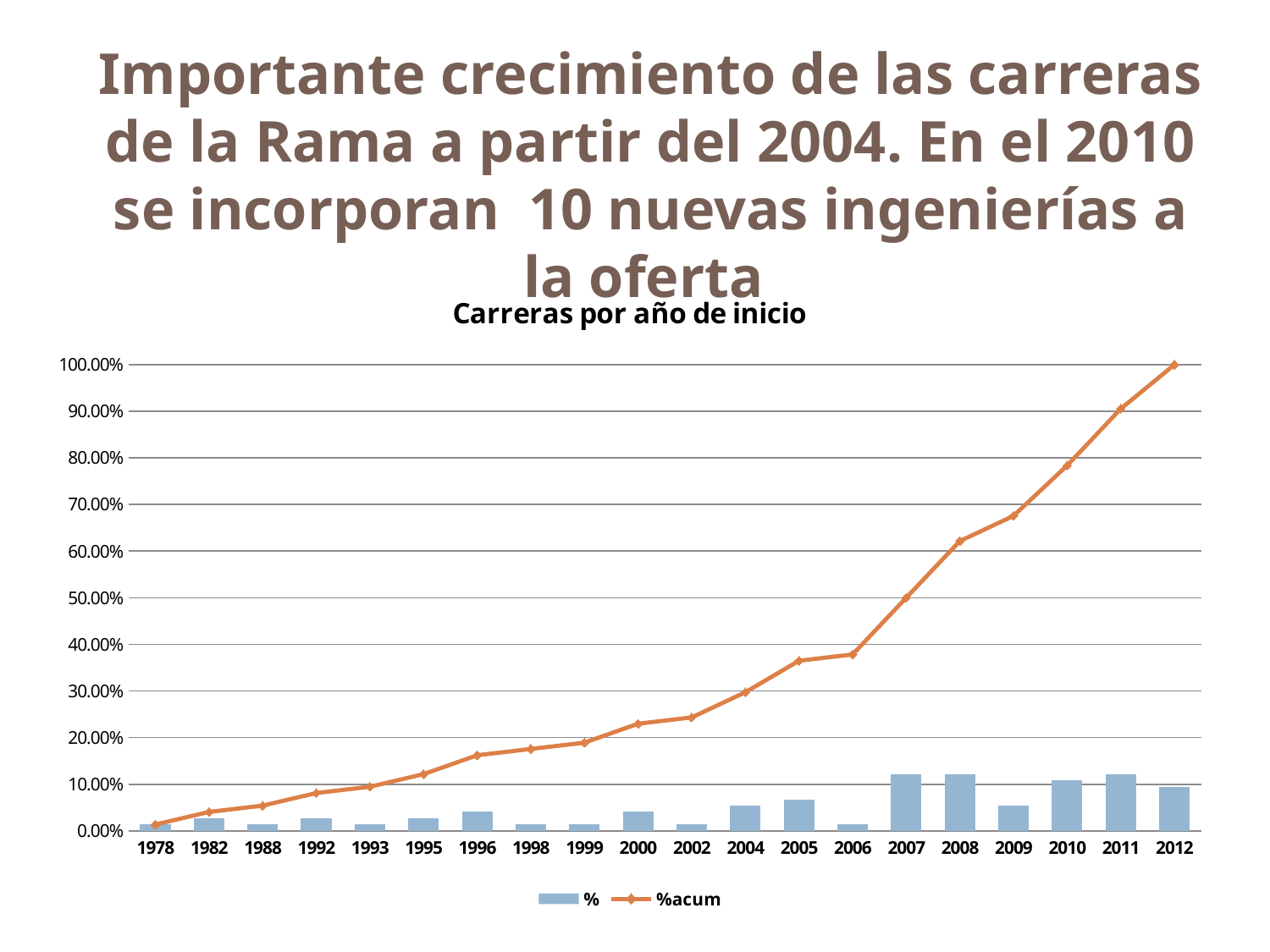
Is the %acum value for 2000 greater or less than 20.00%? greater Which year has the larger % bar, 2009 or 2012? 2012 Is the %acum value for 2005 greater or less than 40.00%? less Does the %acum series rise or fall from 1978 to 2012? rise Which series is drawn as a line in the chart? %acum What is the value of the %acum series for 2012? 100.00% Is the %acum value for 2009 greater or less than 70.00%? less How many years are shown on the x axis of the chart? 20 How many series does the chart legend list? 2 What is the title of the chart? Carreras por año de inicio